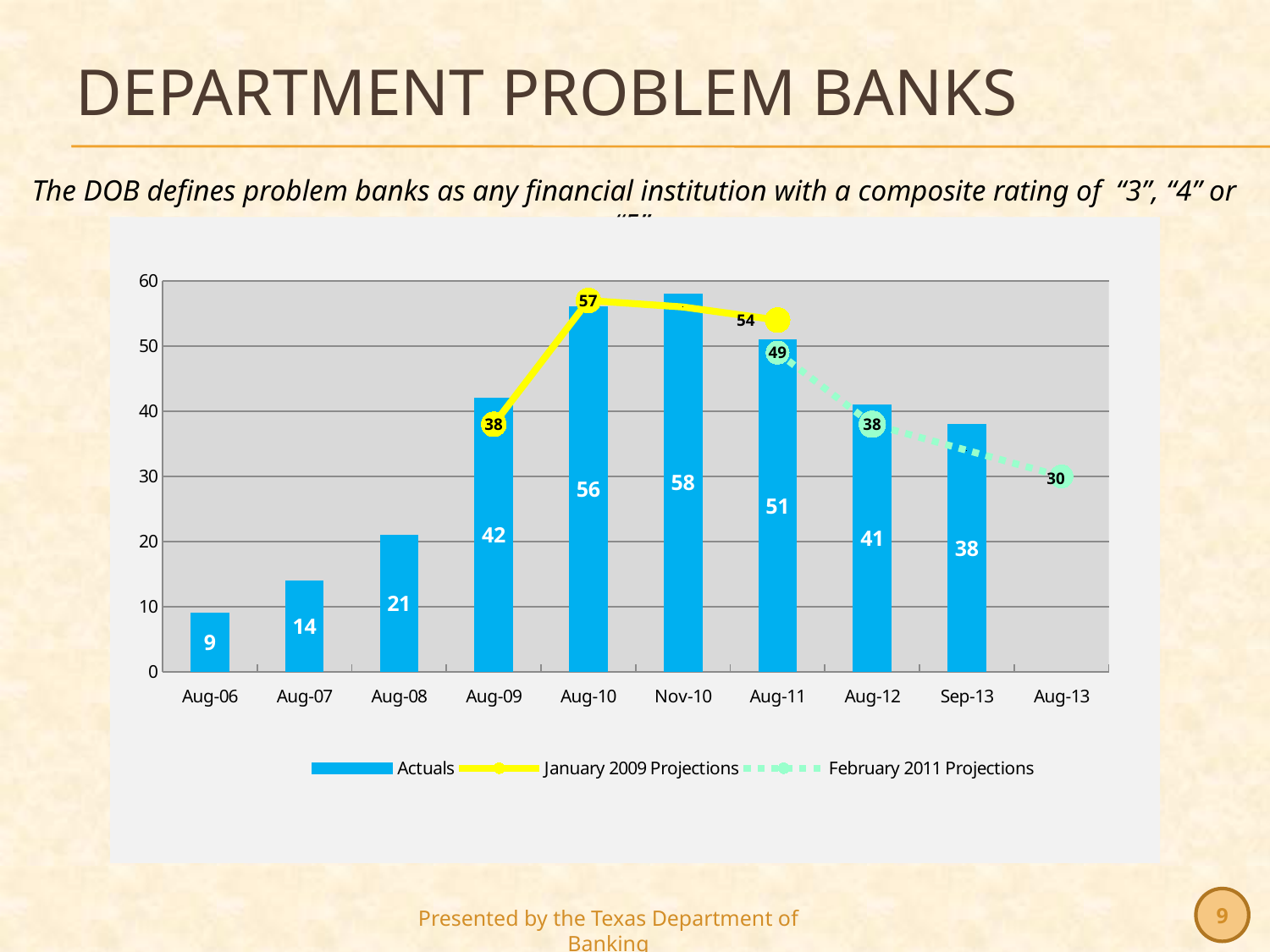
What is the February 2011 Projections value for Aug-13? 30 What is the difference between the Actuals values for Nov-10 and Aug-06? 49 What is the Actuals value for Nov-10? 58 What is the Actuals value for Aug-06? 9 How many series does the legend list? 3 What is the January 2009 Projections value for Aug-10? 57 Which category has the lowest Actuals value? Aug-06 Which is larger, the Actuals value for Aug-09 or for Sep-13? Aug-09 How many categories are shown on the x axis? 10 What colour are the Actuals bars? blue Which category has the highest Actuals value? Nov-10 Do the Actuals values rise or fall from Aug-06 to Nov-10? rise